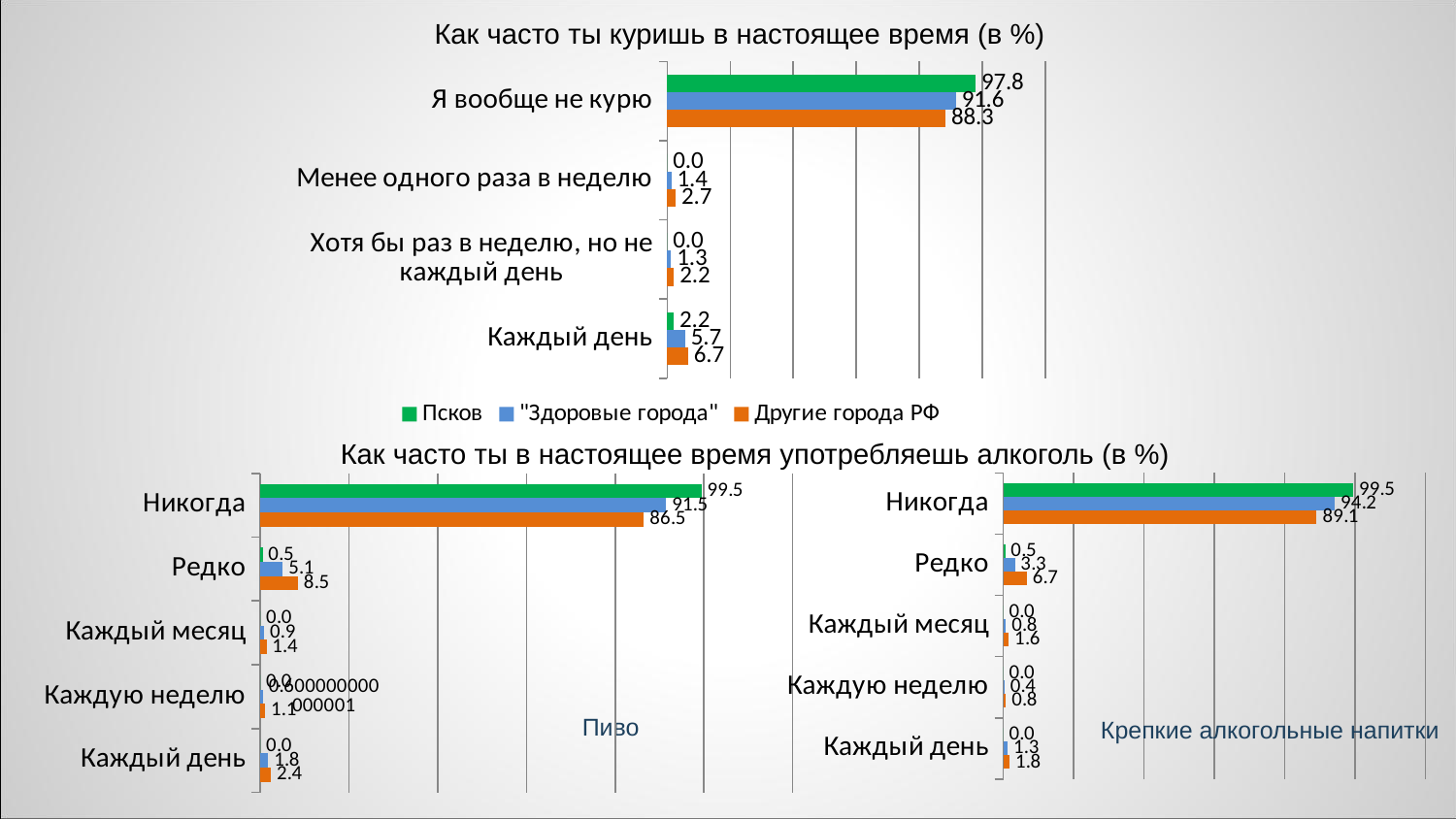
What kind of chart is 'Как часто ты куришь в настоящее время (в %)'? bar chart In the chart 'Как часто ты куришь в настоящее время (в %)', what is the value for 'Другие города РФ' in the category 'Каждый день'? 6.7 In the chart 'Как часто ты куришь в настоящее время (в %)', how many categories are shown? 4 In the chart 'Как часто ты куришь в настоящее время (в %)', what is the value for Псков in the category 'Я вообще не курю'? 97.8 Which colour represents 'Другие города РФ' in the legend? orange In the 'Крепкие алкогольные напитки' chart, what is the value for 'Здоровые города' in the category 'Никогда'? 94.2 In the chart 'Как часто ты куришь в настоящее время (в %)', how many series does the legend list? 3 In the 'Пиво' chart, what is the value for 'Другие города РФ' in the category 'Редко'? 8.5 In the 'Пиво' chart, what is the difference between the Псков and 'Другие города РФ' values for 'Никогда'? 13.0 In the 'Крепкие алкогольные напитки' chart, which is larger for 'Редко': the value for 'Здоровые города' or for 'Другие города РФ'? Другие города РФ In the 'Пиво' chart, which series has the highest value for 'Никогда'? Псков In the chart 'Как часто ты куришь в настоящее время (в %)', what is the difference between the 'Здоровые города' and Псков values for 'Каждый день'? 3.5